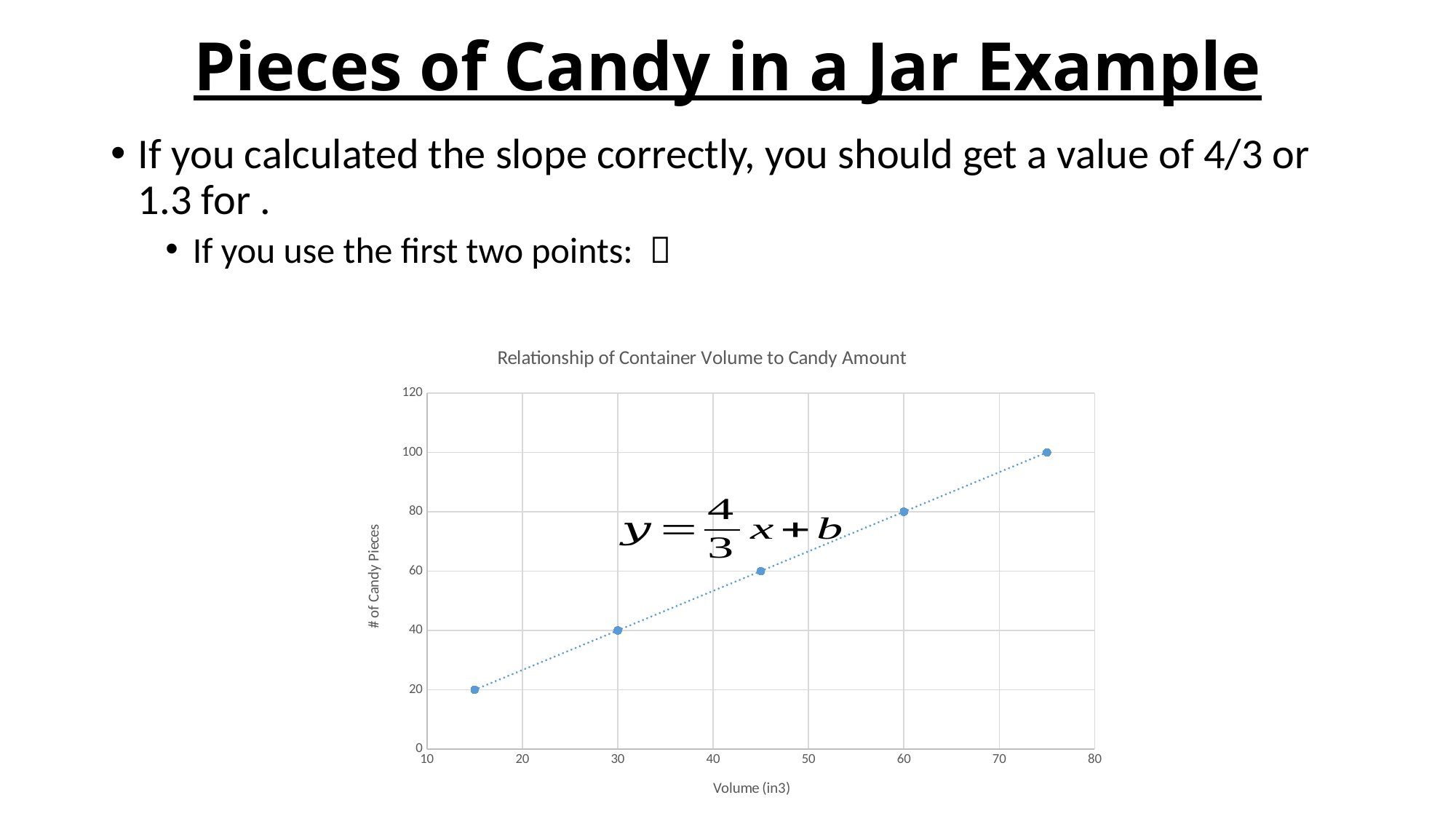
How many data points are plotted on the chart? 5 Do the values rise or fall as volume increases along the x axis? rise What kind of chart is shown on the slide? scatter chart Which has more candy pieces: the point at volume 60 or the point at volume 30? volume 60 What is the label of the x axis of the chart? Volume (in3) What is the difference in candy pieces between the point at volume 60 and the point at volume 30? 40 Is the number of candy pieces for the rightmost point greater or less than 80? greater What is the title of the chart? Relationship of Container Volume to Candy Amount What is the lowest number of candy pieces plotted on the chart? 20 What is the number of candy pieces at a volume of 60? 80 What is the number of candy pieces at a volume of 30? 40 What is the highest number of candy pieces plotted on the chart? 100